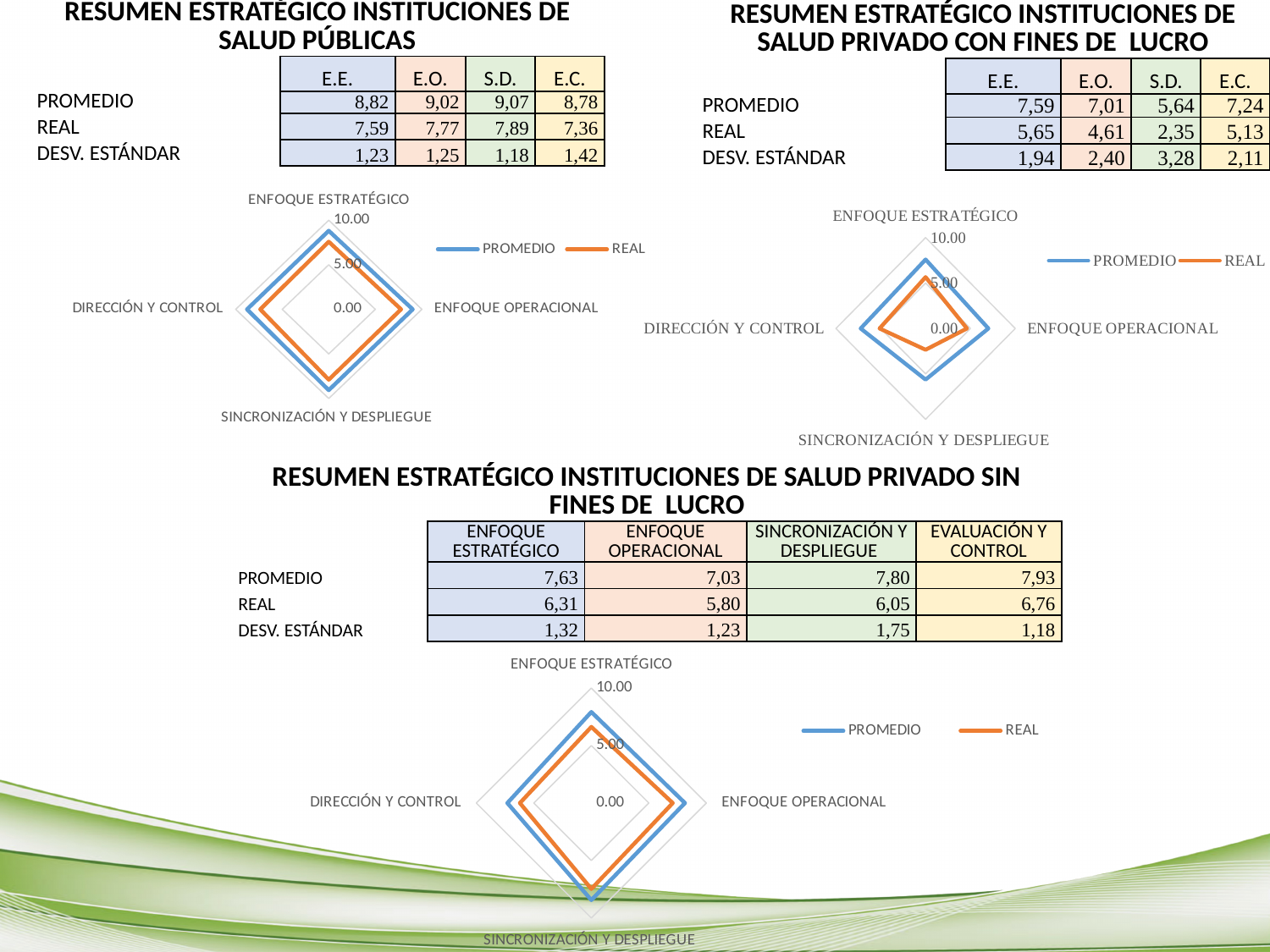
In the chart under 'RESUMEN ESTRATÉGICO INSTITUCIONES DE SALUD PRIVADO CON FINES DE LUCRO', is the REAL value for SINCRONIZACIÓN Y DESPLIEGUE greater or less than 5.00? less In the chart under 'RESUMEN ESTRATÉGICO INSTITUCIONES DE SALUD PRIVADO CON FINES DE LUCRO', is the PROMEDIO value for ENFOQUE ESTRATÉGICO greater or less than 5.00? greater What are the two legend entries in the chart under 'RESUMEN ESTRATÉGICO INSTITUCIONES DE SALUD PRIVADO SIN FINES DE LUCRO'? PROMEDIO and REAL In the chart under 'RESUMEN ESTRATÉGICO INSTITUCIONES DE SALUD PÚBLICAS', is the PROMEDIO value for ENFOQUE ESTRATÉGICO greater or less than 5.00? greater How many categories (axes) are plotted in the chart under 'RESUMEN ESTRATÉGICO INSTITUCIONES DE SALUD PRIVADO SIN FINES DE LUCRO'? 4 In the chart under 'RESUMEN ESTRATÉGICO INSTITUCIONES DE SALUD PRIVADO CON FINES DE LUCRO', which series has the larger value for SINCRONIZACIÓN Y DESPLIEGUE, PROMEDIO or REAL? PROMEDIO In the chart under 'RESUMEN ESTRATÉGICO INSTITUCIONES DE SALUD PÚBLICAS', which series has the larger value for ENFOQUE ESTRATÉGICO, PROMEDIO or REAL? PROMEDIO What is the maximum axis tick value shown on the radar chart under 'RESUMEN ESTRATÉGICO INSTITUCIONES DE SALUD PÚBLICAS'? 10.00 What type of chart is shown under the title 'RESUMEN ESTRATÉGICO INSTITUCIONES DE SALUD PÚBLICAS'? Radar chart How many series does the legend list in the chart under 'RESUMEN ESTRATÉGICO INSTITUCIONES DE SALUD PRIVADO CON FINES DE LUCRO'? 2